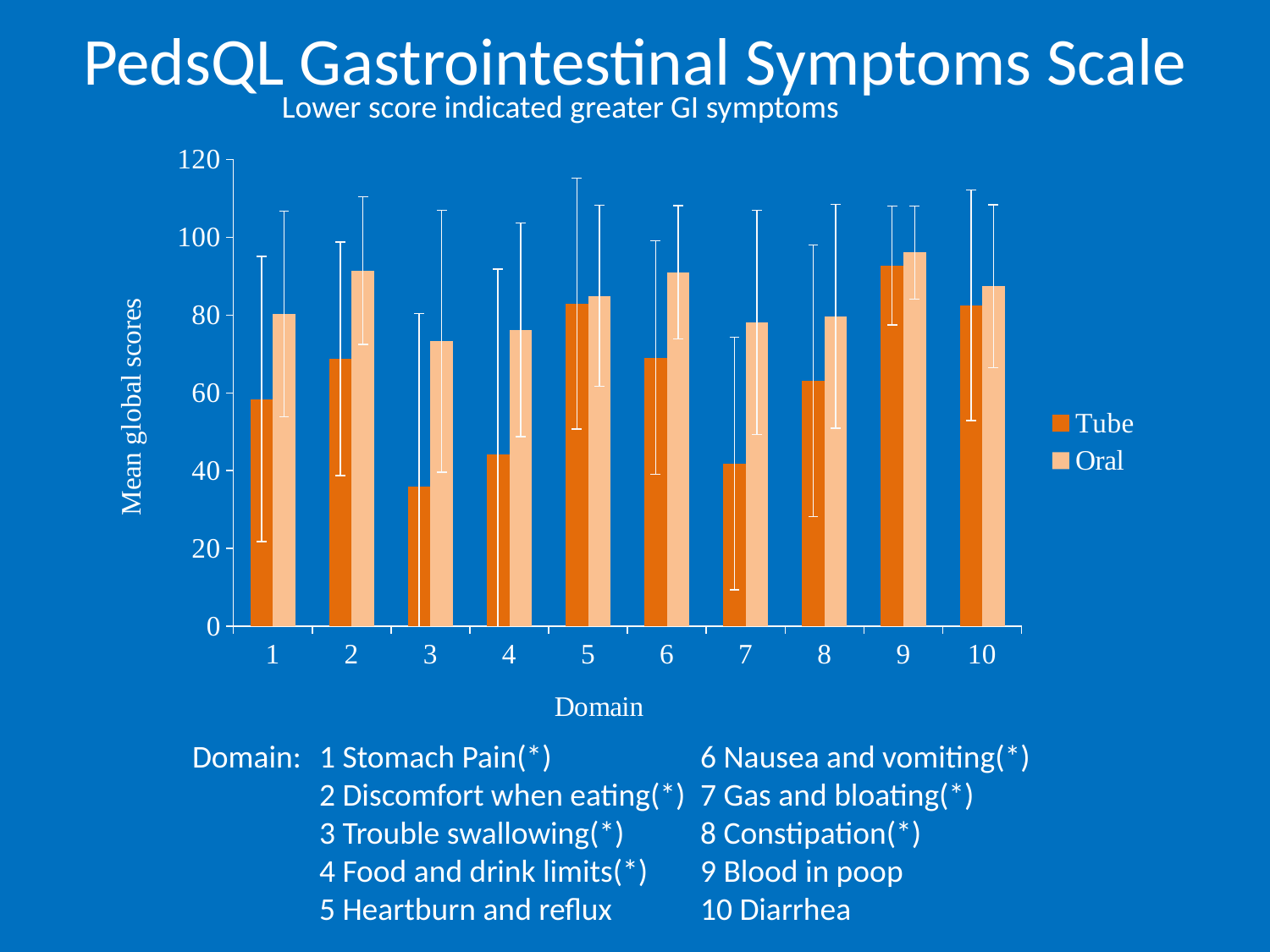
How many domains are plotted along the x axis? 10 Is the Oral value for domain 2 greater or less than 80? greater Which domain has the highest Oral score? 9 How many series does the legend list? 2 Is the Tube value for domain 9 greater or less than 80? greater For domain 3, which series has the larger value, Tube or Oral? Oral What is the label of the y axis? Mean global scores Is the Tube value for domain 3 greater or less than 40? less Which domain has the lowest Tube score? 3 Which domain has the highest Tube score? 9 What kind of chart is shown on the slide? bar chart For domain 1, which series has the larger value, Tube or Oral? Oral